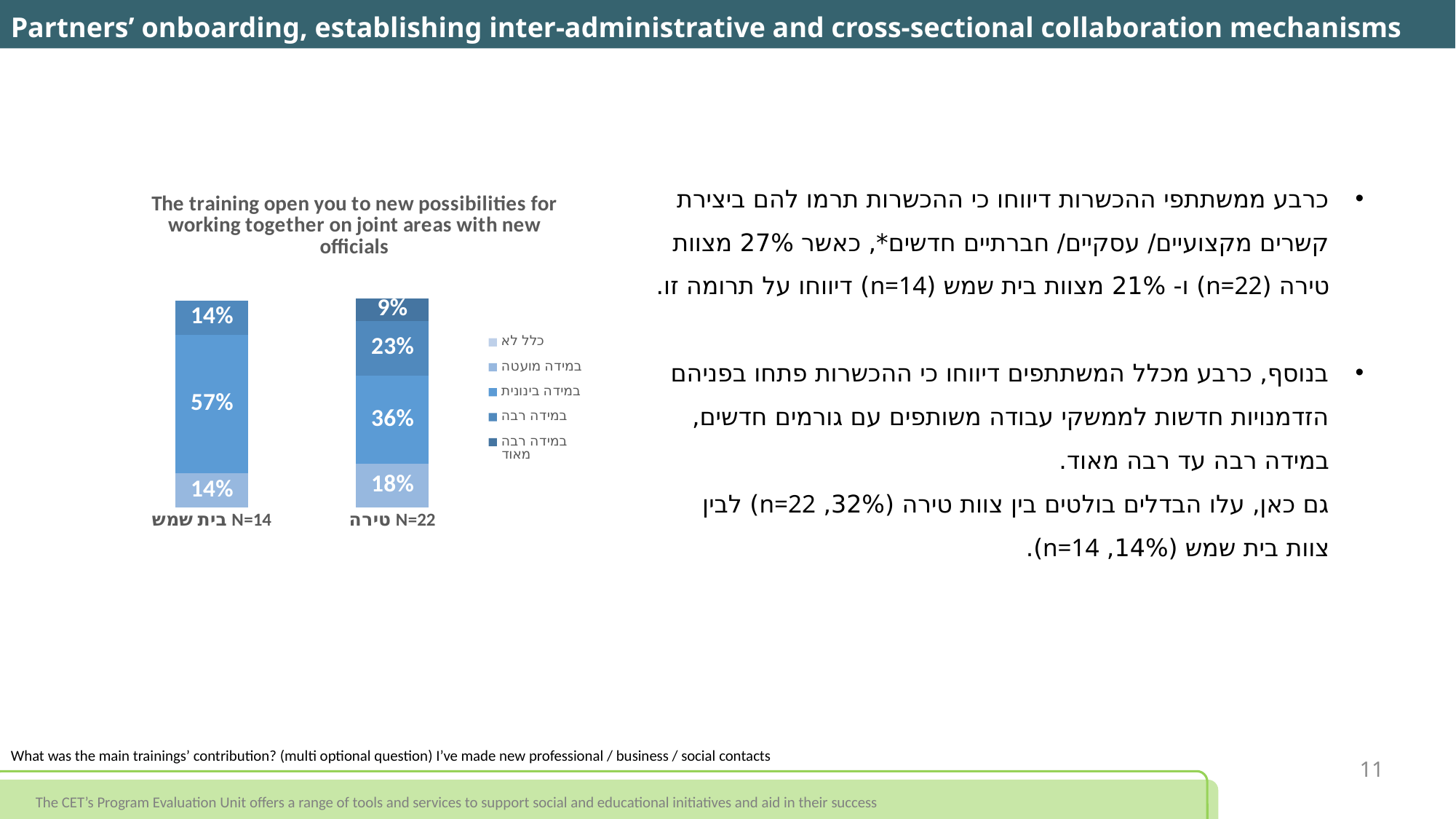
What is the difference between the largest segment of the בית שמש bar (57%) and the largest segment of the טירה bar (36%)? 21 percentage points What is the value of the top segment of the טירה bar? 9% Which bar contains the single largest segment in the chart? בית שמש How many bars (groups) does the chart show? 2 Which bar has the larger bottom segment, בית שמש or טירה? טירה How many series does the chart's legend list? 5 What is the value of the largest segment in the בית שמש bar? 57% What is the sum of the labelled segments in the טירה bar? 86% What is the value of the bottom segment of the טירה bar? 18% What kind of chart is shown on the slide? Stacked bar chart What is the value of the second segment from the bottom in the טירה bar? 36% What sample size (N) is shown for the טירה bar? N=22